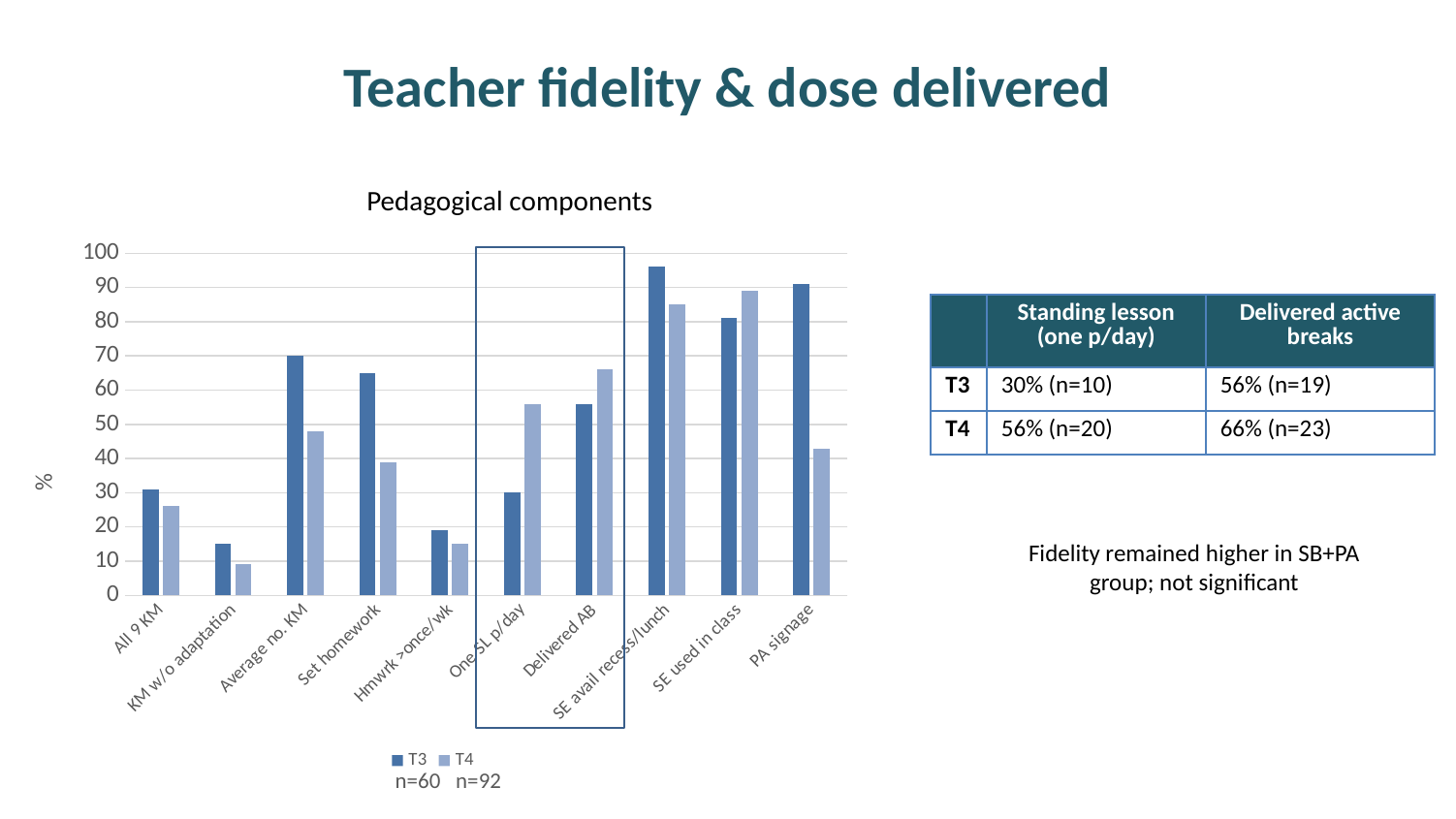
How many categories are shown on the x axis of the chart? 10 For Average no. KM, which is larger, the T3 value or the T4 value? T3 Which category has the highest T3 bar? SE avail recess/lunch Which category has the lowest T4 bar? KM w/o adaptation Is the T4 value for SE used in class greater or less than 80? greater What is the T3 value for Average no. KM? 70 What is the title of the chart? Pedagogical components How many series does the chart legend list? 2 What are the two series named in the chart legend? T3 and T4 What is the T3 value for One SL p/day? 30 What kind of chart is shown on the slide? bar chart